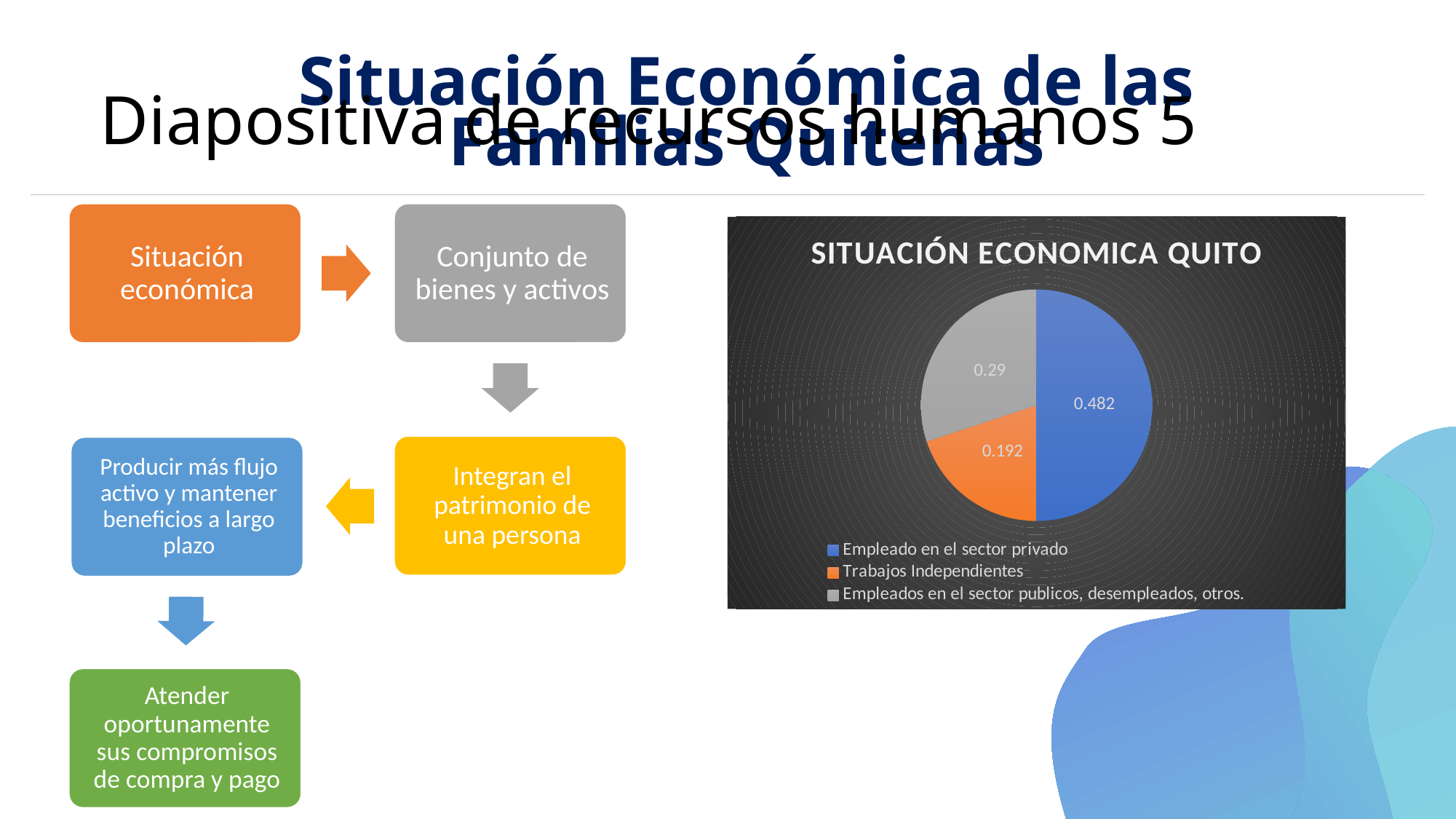
What is the difference between the values for Empleado en el sector privado and Trabajos Independientes? 0.29 What is the value for Empleado en el sector privado? 0.482 Which is larger, the value for Empleados en el sector publicos, desempleados, otros. or the value for Trabajos Independientes? Empleados en el sector publicos, desempleados, otros. What type of chart is shown on the slide? pie chart What is the difference between the values for Empleados en el sector publicos, desempleados, otros. and Trabajos Independientes? 0.098 What is the value for Trabajos Independientes? 0.192 What is the value for Empleados en el sector publicos, desempleados, otros.? 0.29 Which category has the smallest slice of the pie? Trabajos Independientes What colour is the slice for Trabajos Independientes? orange How many slices does the pie chart have? 3 What is the title of the chart? SITUACIÓN ECONOMICA QUITO Which category has the largest slice of the pie? Empleado en el sector privado